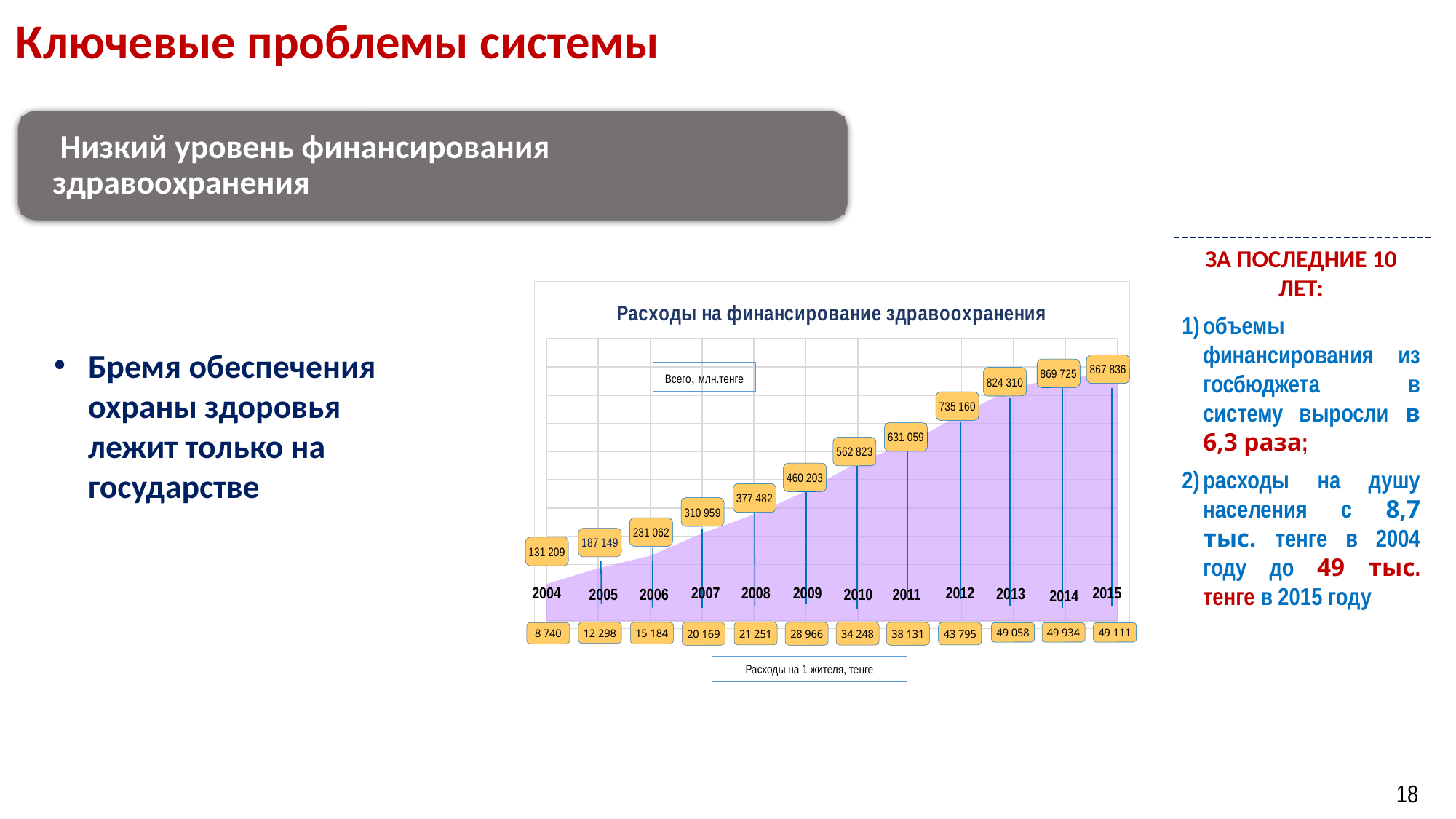
How many years are plotted on the x axis of the chart? 12 What is the per-capita expenditure (Расходы на 1 жителя, тенге) for 2014? 49 934 What is the title of the chart? Расходы на финансирование здравоохранения Does the total health financing expenditure generally rise or fall from 2004 to 2015? rise What is the difference between the total expenditure (Всего, млн.тенге) in 2015 and in 2004? 736 627 What is the per-capita expenditure (Расходы на 1 жителя, тенге) for 2009? 28 966 What is the total health financing expenditure (Всего, млн.тенге) for 2004? 131 209 What is the total health financing expenditure (Всего, млн.тенге) for 2010? 562 823 Which year has the lowest total health financing expenditure (Всего, млн.тенге)? 2004 What is the total health financing expenditure (Всего, млн.тенге) for 2015? 867 836 What kind of chart is used to show the total health financing expenditure? area chart Which year has the highest total health financing expenditure (Всего, млн.тенге)? 2014